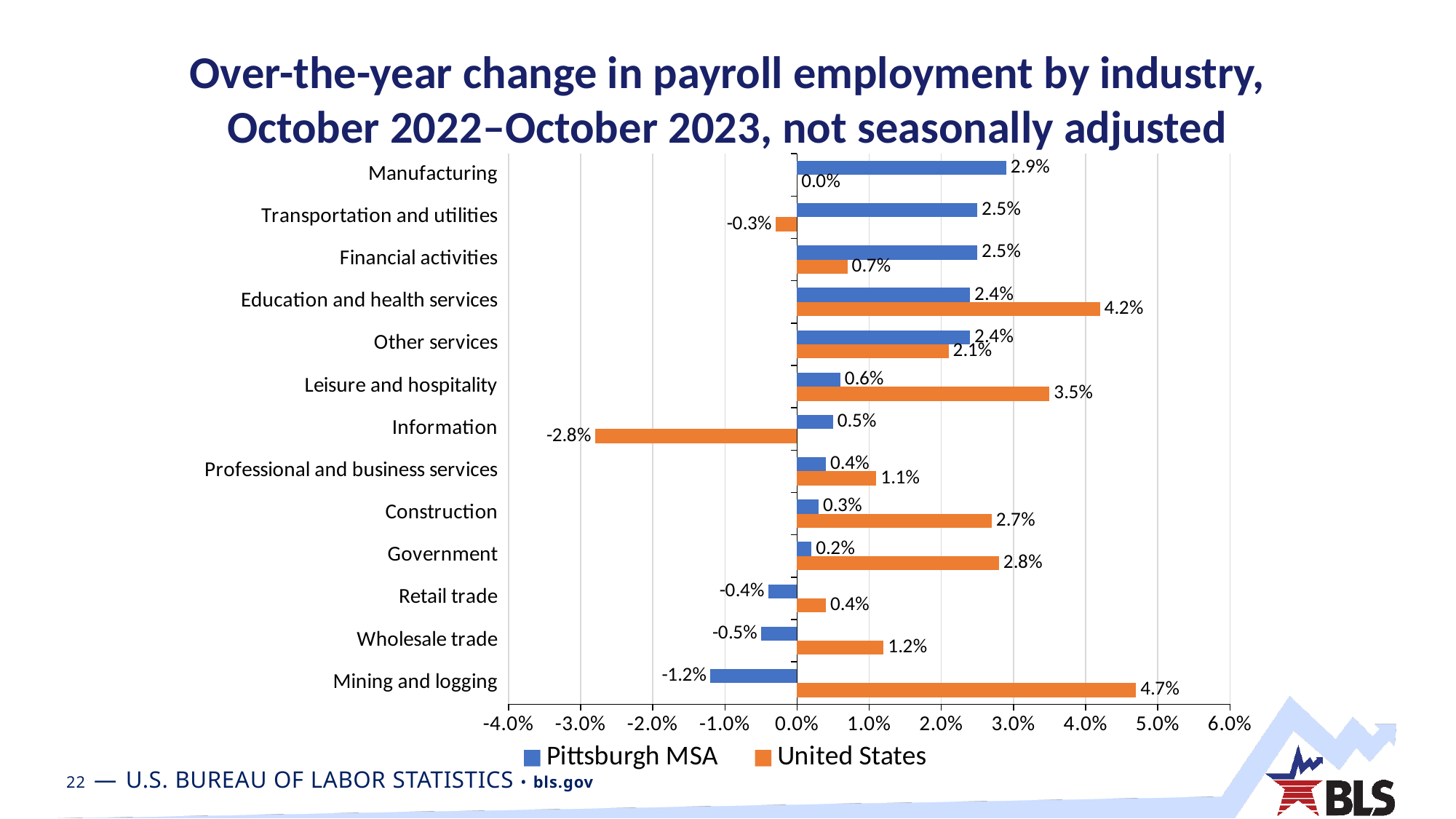
How many industries are shown on the chart? 13 What is the Pittsburgh MSA value for Manufacturing? 2.9% What is the United States value for Information? -2.8% Which industry has the highest Pittsburgh MSA value? Manufacturing Which industry has the lowest United States value? Information How many series does the legend list? 2 What kind of chart is shown on the slide? Bar chart Which colour represents the United States series? Orange Which is larger for Government, the Pittsburgh MSA value or the United States value? United States What is the difference between the United States and Pittsburgh MSA values for Education and health services? 1.8% What is the United States value for Mining and logging? 4.7% Which industry has the lowest Pittsburgh MSA value? Mining and logging